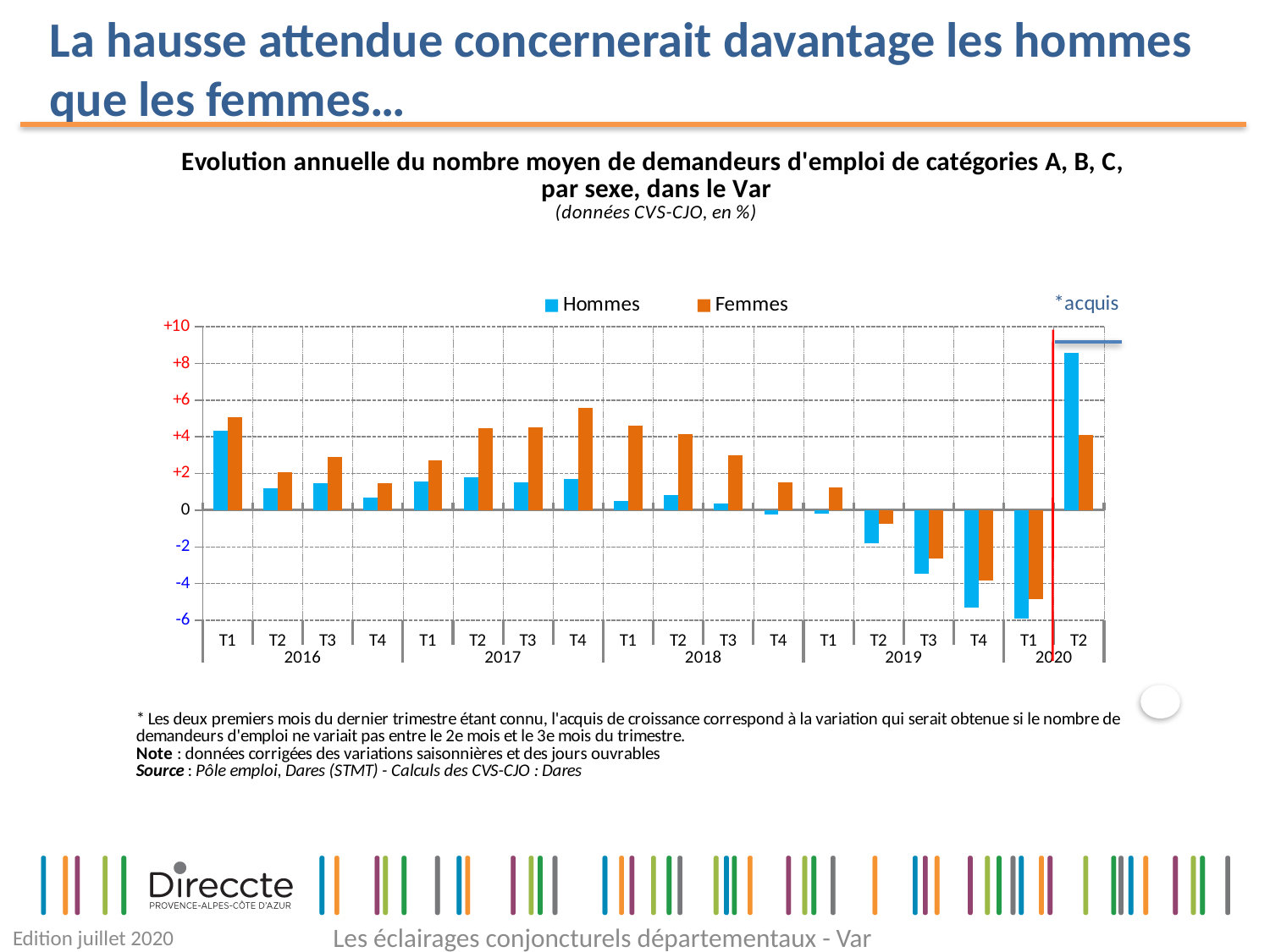
Is the Hommes value for T2 2020 greater or less than +8? greater In T1 2018, which series has the larger value, Hommes or Femmes? Femmes In T2 2020, which series has the larger value, Hommes or Femmes? Hommes In which quarter is the Femmes value lowest? T1 2020 In which quarter is the Hommes value highest? T2 2020 How many quarters are plotted along the x axis? 18 Is the Hommes value for T4 2019 greater or less than -4? less Is the Femmes value for T4 2017 greater or less than +4? greater Which colour represents the Femmes series in the legend? Orange What kind of chart is shown on the slide? Bar chart How many series does the legend list? 2